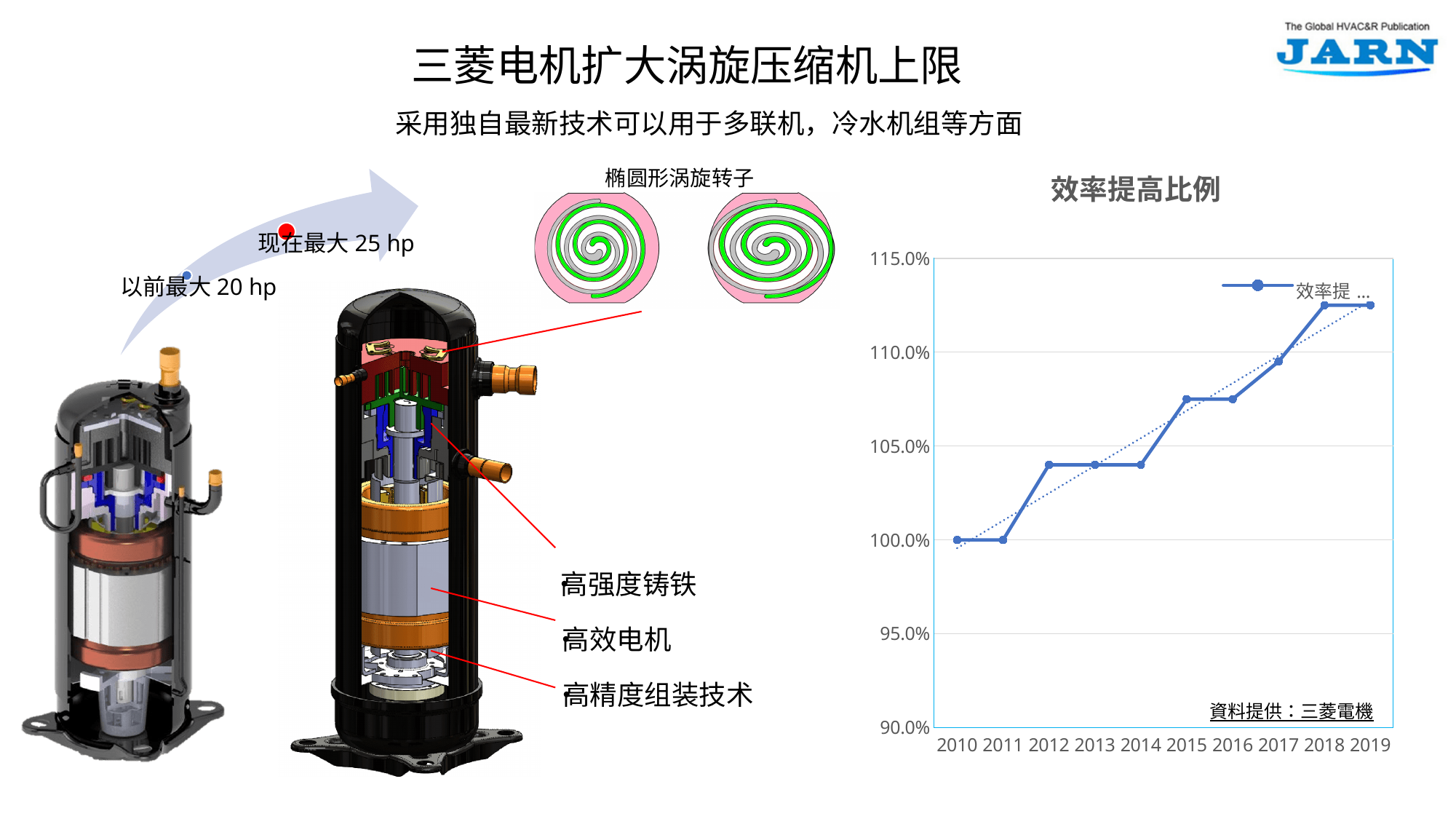
What is the title of the chart on the right of the slide? 效率提高比例 What kind of chart is shown on the slide? line chart Is the value for 2016 greater or less than 105.0%? greater Is the value for 2013 greater or less than 105.0%? less How many years are plotted along the x axis of the chart? 10 Is the value for 2018 greater or less than 110.0%? greater Which is larger in the chart, the value for 2015 or the value for 2012? 2015 What is the value for 2011 in the chart? 100.0% What is the lowest value shown on the y axis of the chart? 90.0% What is the value for 2010 in the chart? 100.0% Do the values in the chart generally rise or fall from 2010 to 2019? rise